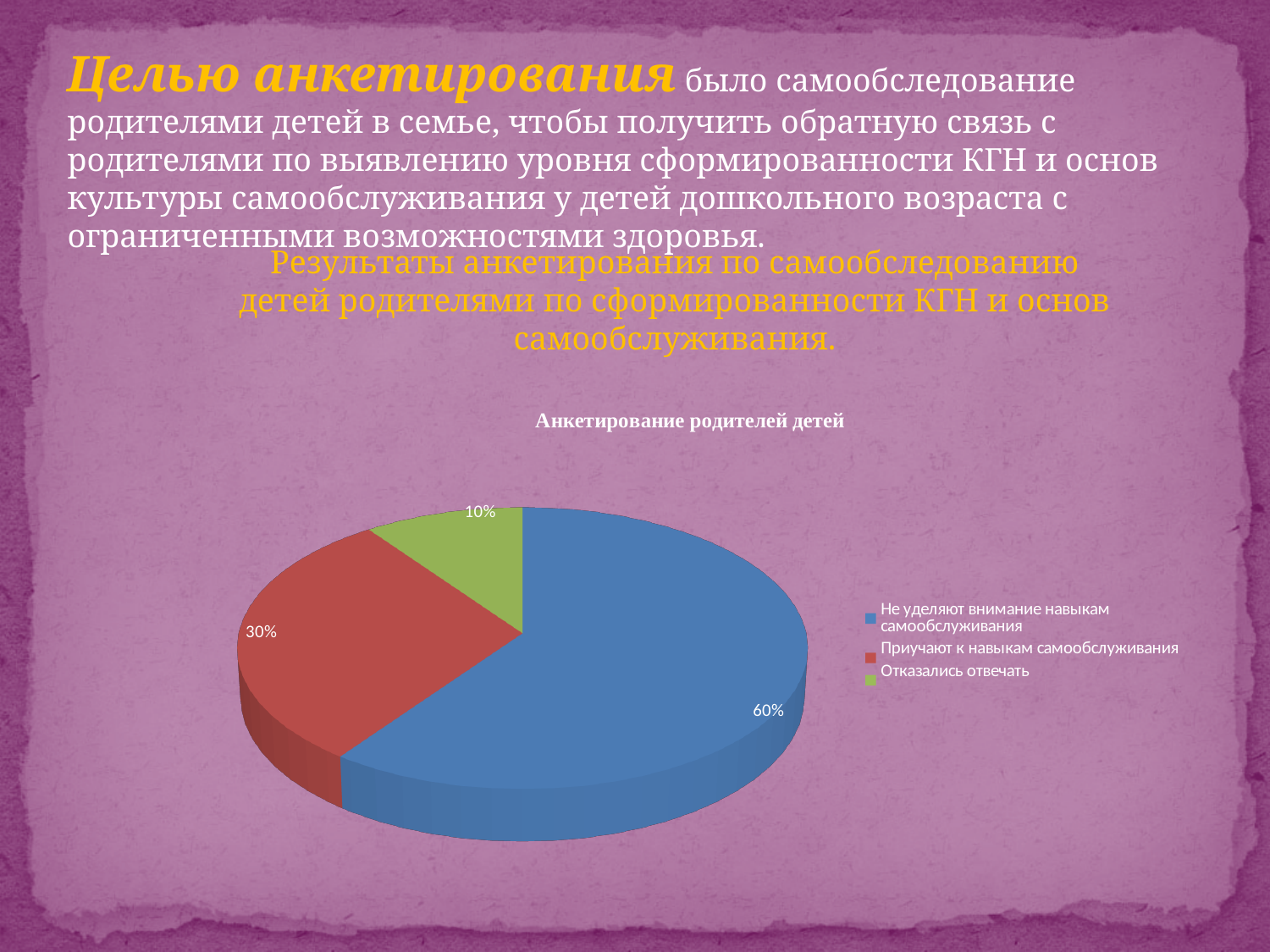
What percentage of the pie is labelled for 'Не уделяют внимание навыкам самообслуживания'? 60% What percentage of the pie is labelled for 'Отказались отвечать'? 10% What type of chart is shown on the slide? pie chart Which is larger: the share for 'Приучают к навыкам самообслуживания' or the share for 'Отказались отвечать'? Приучают к навыкам самообслуживания What is the title of the chart? Анкетирование родителей детей What is the difference in percentage points between 'Не уделяют внимание навыкам самообслуживания' and 'Приучают к навыкам самообслуживания'? 30 Which category has the largest share of the pie? Не уделяют внимание навыкам самообслуживания Which category has the smallest share of the pie? Отказались отвечать How many entries does the legend list? 3 What percentage of the pie is labelled for 'Приучают к навыкам самообслуживания'? 30% What colour is the slice for 'Отказались отвечать'? green How many slices does the pie chart have? 3